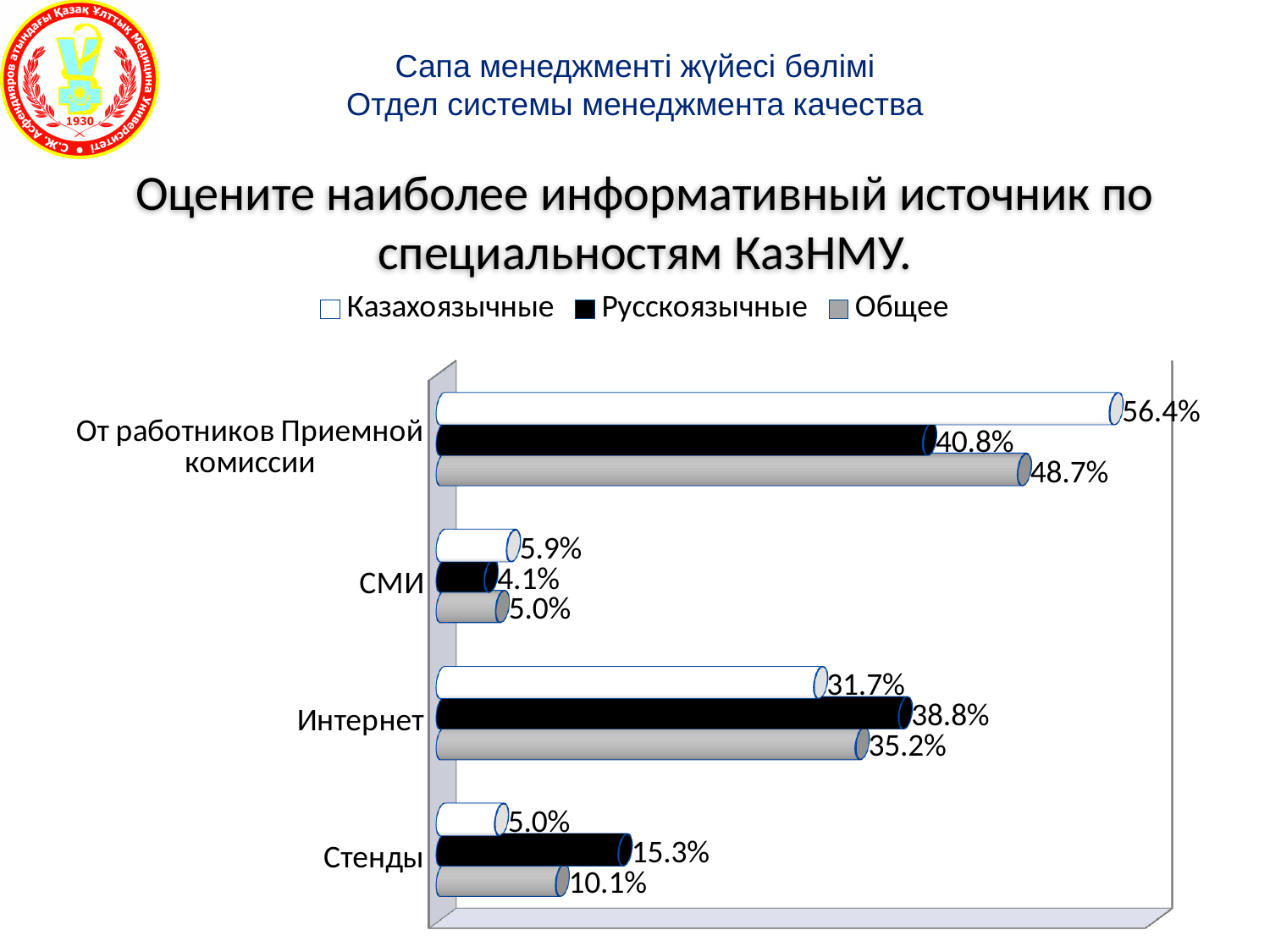
How many series does the legend list? 3 Which category has the highest value for the Общее series? От работников Приемной комиссии What kind of chart is shown on the slide? bar chart What is the value for Русскоязычные for Интернет? 38.8% What is the value for Общее for Стенды? 10.1% Which category has the lowest value for the Казахоязычные series? Стенды What is the value for Русскоязычные for СМИ? 4.1% What is the difference between the Казахоязычные and Русскоязычные values for От работников Приемной комиссии? 15.6% What is the title of the chart? Оцените наиболее информативный источник по специальностям КазНМУ. What is the value for Казахоязычные for От работников Приемной комиссии? 56.4% Which is larger for Интернет: the Казахоязычные value or the Русскоязычные value? Русскоязычные How many categories are shown on the chart? 4